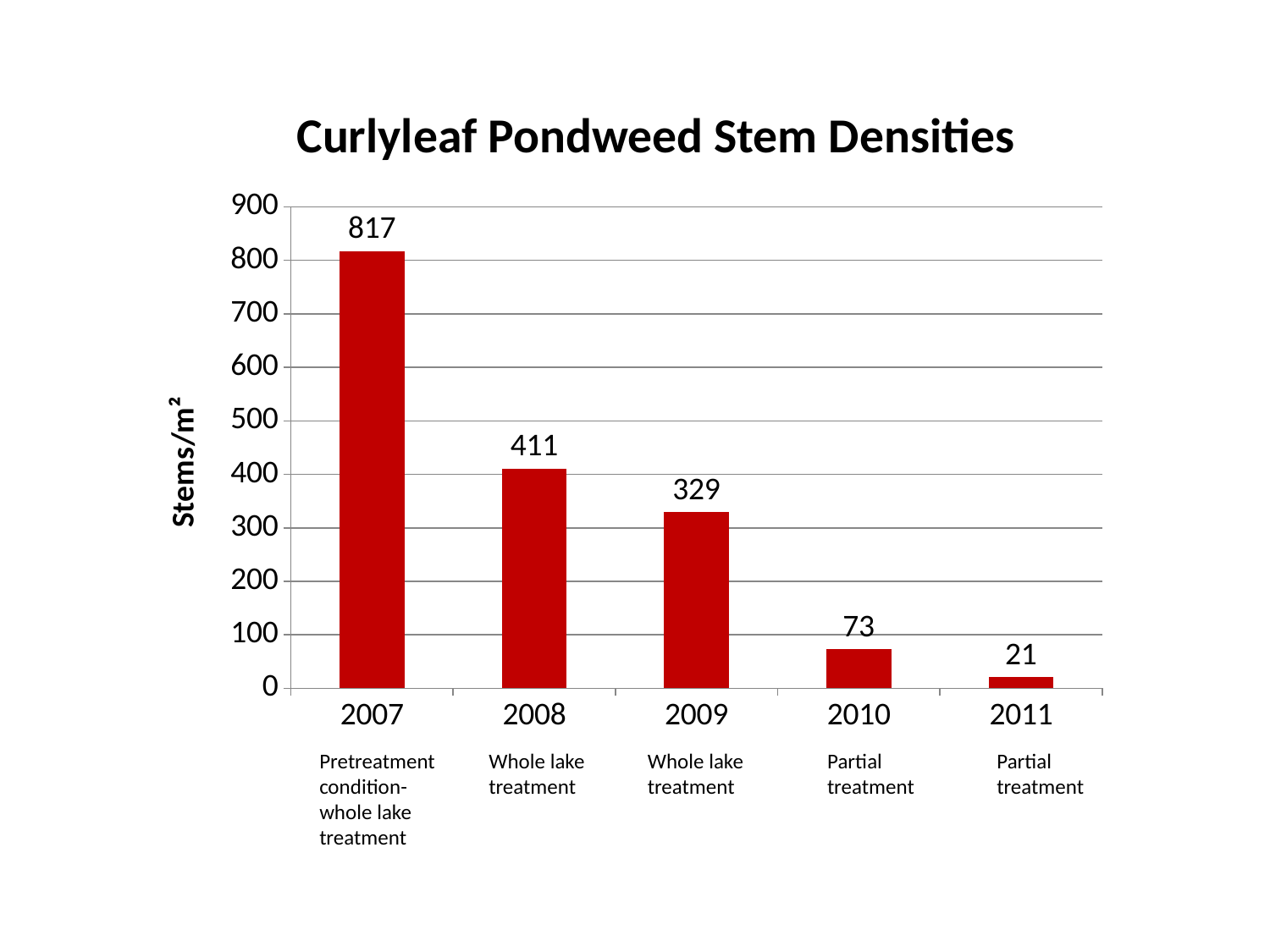
What is the stem density value for 2007? 817 What is the stem density value for 2011? 21 What is the difference between the stem density in 2007 and in 2008? 406 Which year has a larger stem density, 2008 or 2009? 2008 Which year has the lowest stem density? 2011 What is the difference between the stem density in 2010 and in 2011? 52 What is the stem density value for 2009? 329 Which year has the highest stem density? 2007 What kind of chart is this? bar chart Is the value for 2010 greater or less than 100? less Do the stem density values rise or fall from 2007 to 2011? fall How many years are shown on the x axis? 5